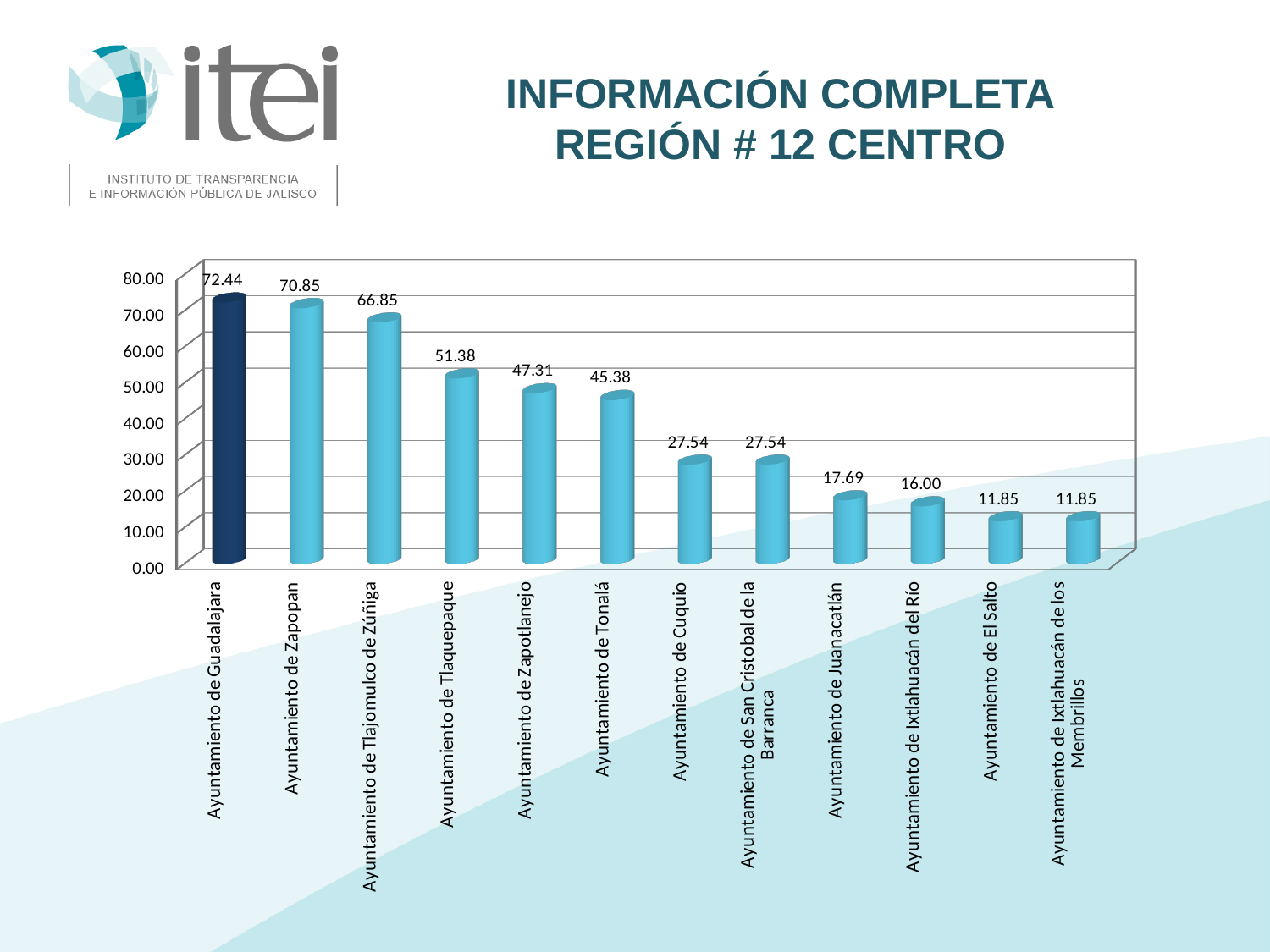
What is the value for Ayuntamiento de Zapopan? 70.85 Which category has the highest value? Ayuntamiento de Guadalajara How many categories are shown in the chart? 12 What is the value for Ayuntamiento de Ixtlahuacán del Río? 16.00 What kind of chart is shown on the slide? Bar chart What is the title of the slide containing the chart? INFORMACIÓN COMPLETA REGIÓN # 12 CENTRO Which is larger, the value for Ayuntamiento de Zapotlanejo or the value for Ayuntamiento de Tonalá? Ayuntamiento de Zapotlanejo What is the value for Ayuntamiento de Tlaquepaque? 51.38 What is the difference between the values for Ayuntamiento de Guadalajara and Ayuntamiento de Zapopan? 1.59 What is the value for Ayuntamiento de Juanacatlán? 17.69 Do the values rise or fall from left to right along the x axis? Fall What is the difference between the values for Ayuntamiento de Tlajomulco de Zúñiga and Ayuntamiento de Cuquio? 39.31